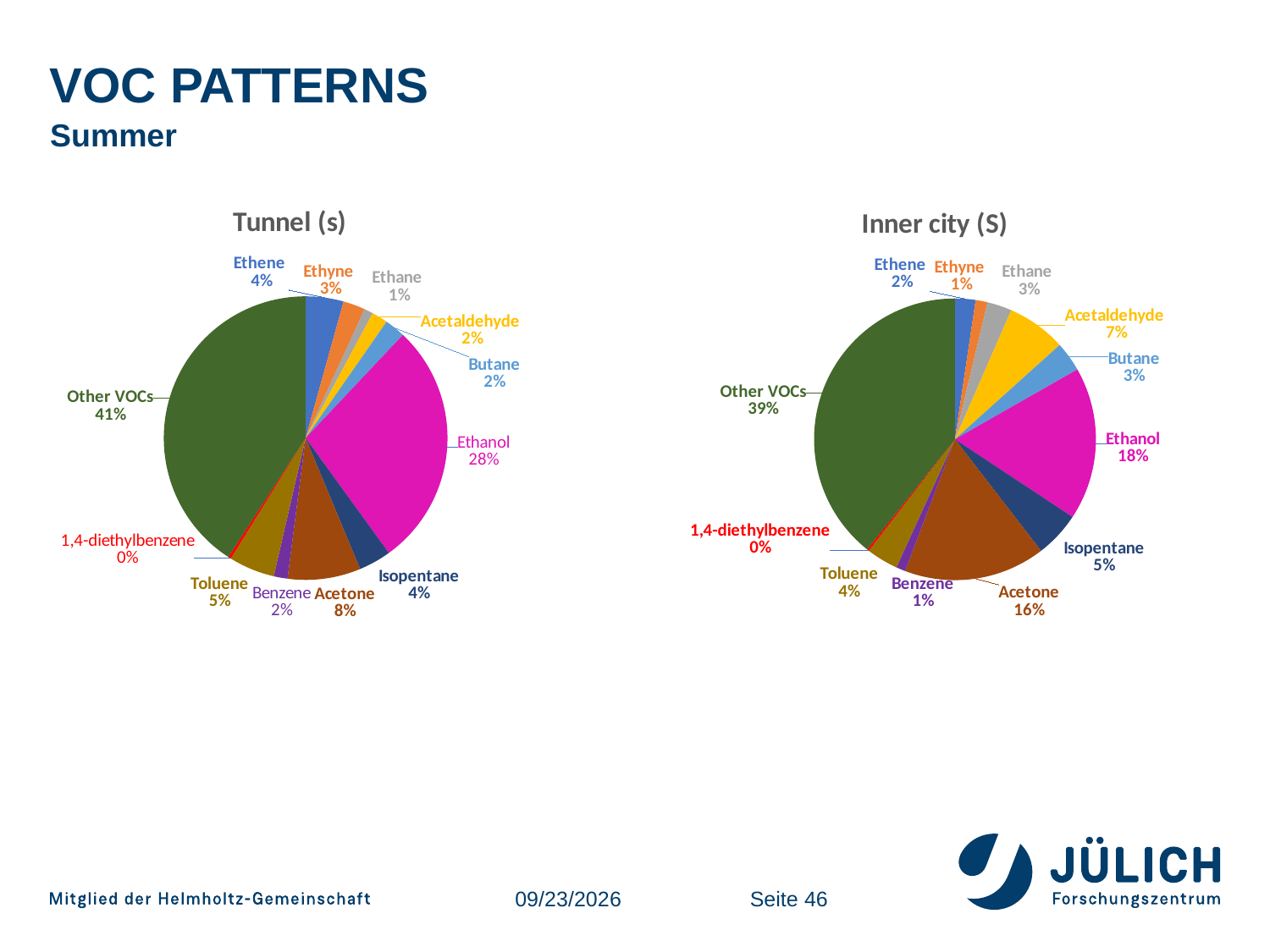
What is the title of the chart on the left of the slide? Tunnel (s) In the Inner city (S) chart, what share does Acetone have? 16% How many categories are shown in the Tunnel (s) chart? 12 In the Tunnel (s) chart, what share does Benzene have? 2% In the Inner city (S) chart, what share does Acetaldehyde have? 7% In the Inner city (S) chart, which category has the smallest slice? 1,4-diethylbenzene In the Inner city (S) chart, what is the difference between the Ethanol and Acetone shares? 2% In the Tunnel (s) chart, which is larger, the Acetone slice or the Toluene slice? Acetone In the Tunnel (s) chart, which category has the largest slice? Other VOCs What kind of chart is the Inner city (S) chart? Pie chart In the Tunnel (s) chart, what is the difference between the Other VOCs and Ethanol shares? 13%